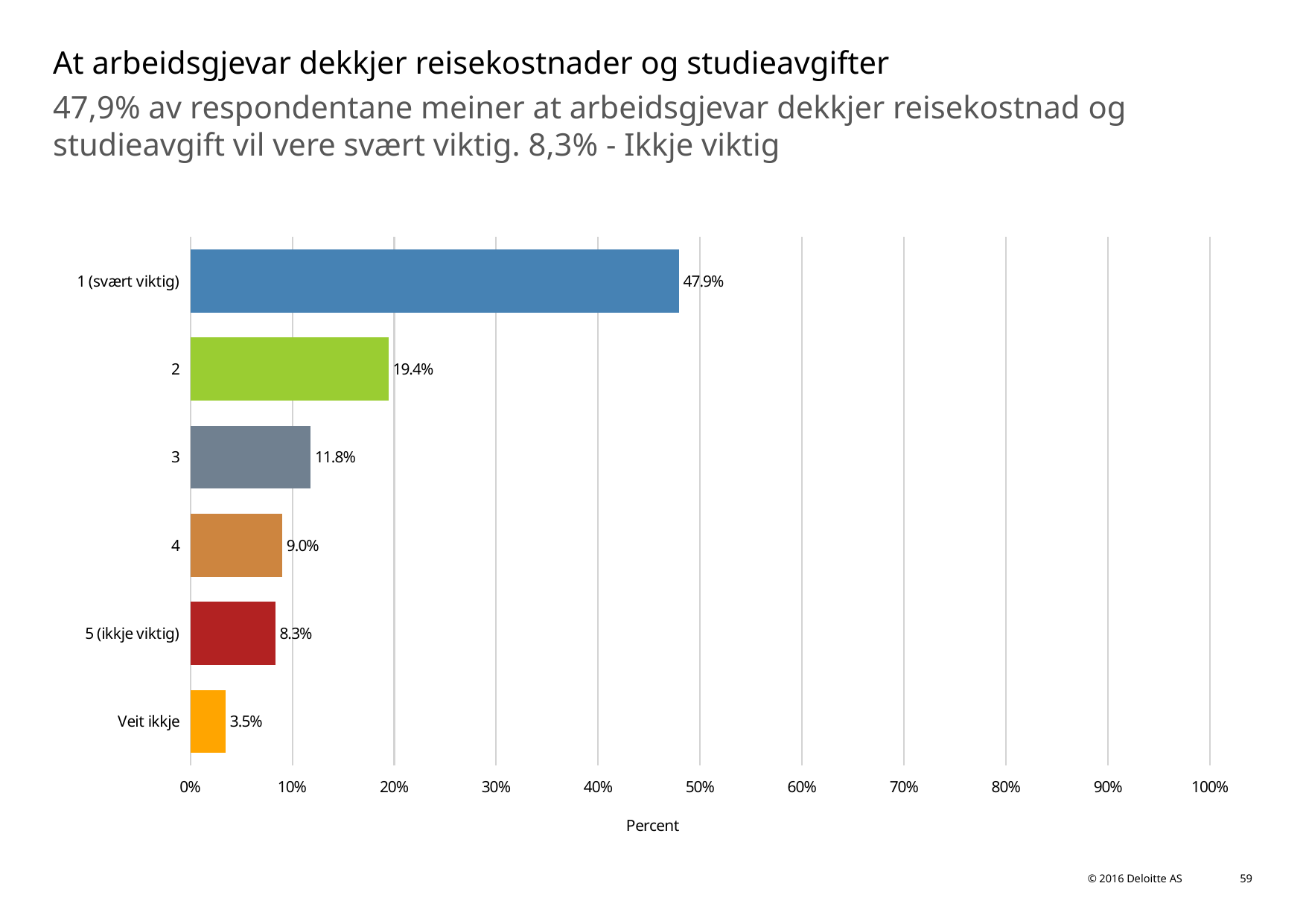
What is the value for "1 (svært viktig)"? 47.9% Which category has the lowest value? Veit ikkje Which is larger, the value for "4" or the value for "5 (ikkje viktig)"? 4 What kind of chart is shown on the slide? bar chart Is the value for "1 (svært viktig)" greater or less than 50%? less Which category has the highest value? 1 (svært viktig) What is the value for "Veit ikkje"? 3.5% What is the difference between the values for "2" and "3"? 7.6% What is the value for category "3"? 11.8% What colour is the bar for "5 (ikkje viktig)"? red How many categories are shown in the chart? 6 What is the label of the horizontal axis? Percent